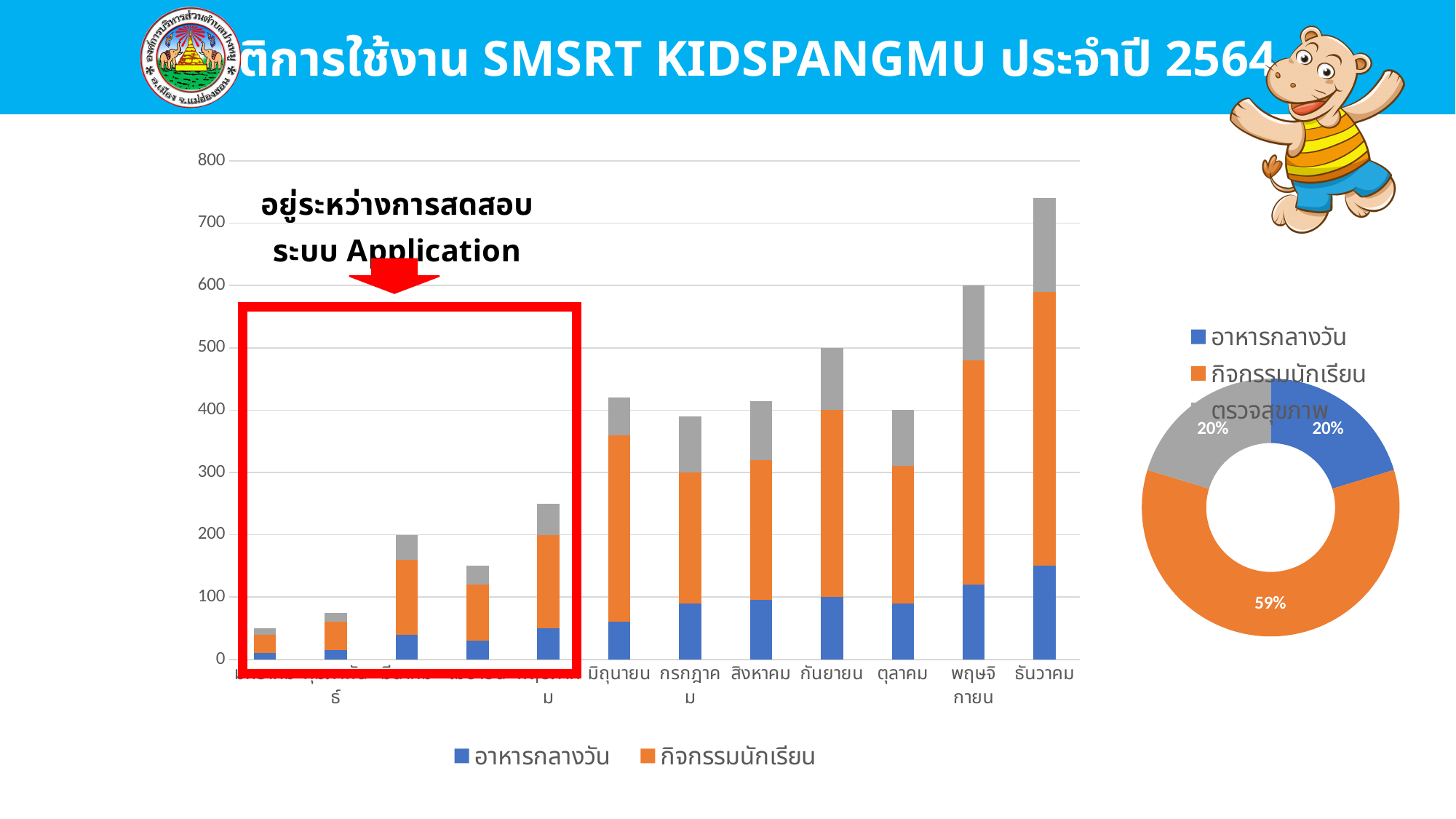
In the doughnut chart, what share does กิจกรรมนักเรียน have? 59% How many entries does the legend of the doughnut chart list? 3 How many entries does the legend below the bar chart list? 2 What kind of chart is the large chart on the left of the slide? Stacked bar chart In the bar chart, which stacked bar is taller, พฤศจิกายน or ธันวาคม? ธันวาคม In the doughnut chart, which category has the largest share? กิจกรรมนักเรียน In the doughnut chart, what share does อาหารกลางวัน have? 20% What kind of chart is shown on the right of the slide? Doughnut chart How many bars are plotted in the bar chart? 12 In the bar chart, is the total for ธันวาคม greater or less than 700? greater In the bar chart, which month has the tallest stacked bar? ธันวาคม